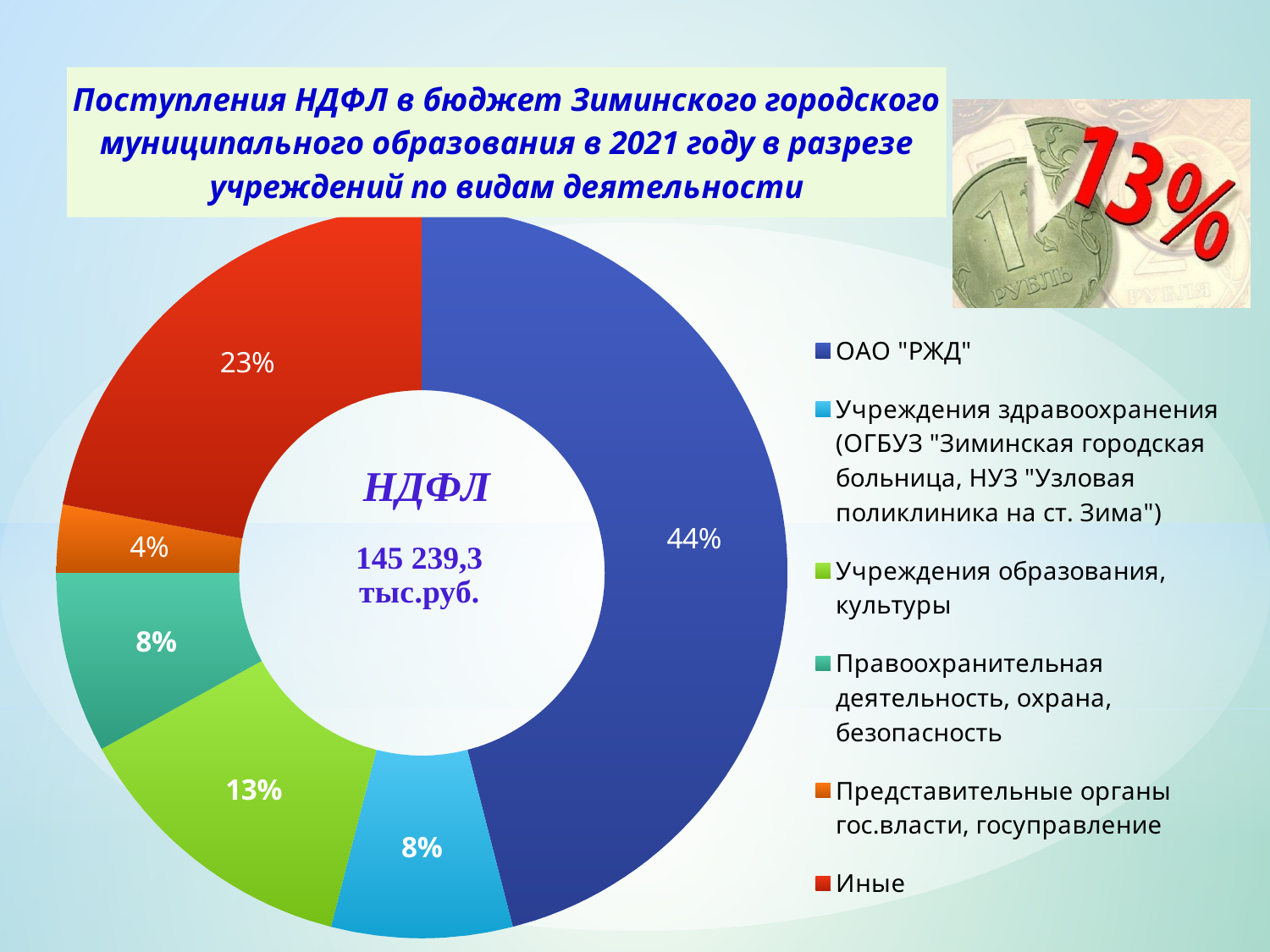
Which category has the smallest share of the chart? Представительные органы гос.власти, госуправление What percentage is shown for Учреждения образования, культуры? 13% What colour is the slice for Иные? Red What percentage is shown for Иные? 23% Which is larger: the share for Учреждения образования, культуры or the share for Учреждения здравоохранения? Учреждения образования, культуры What kind of chart is shown on the slide? Doughnut (pie) chart What share of the chart does ОАО "РЖД" account for? 44% What is the difference in percentage points between ОАО "РЖД" and Иные? 21 What total amount of НДФЛ is printed in the centre of the chart? 145 239,3 тыс.руб. Which category has the largest share of the chart? ОАО "РЖД" How many categories does the legend list? 6 What percentage is shown for Представительные органы гос.власти, госуправление? 4%